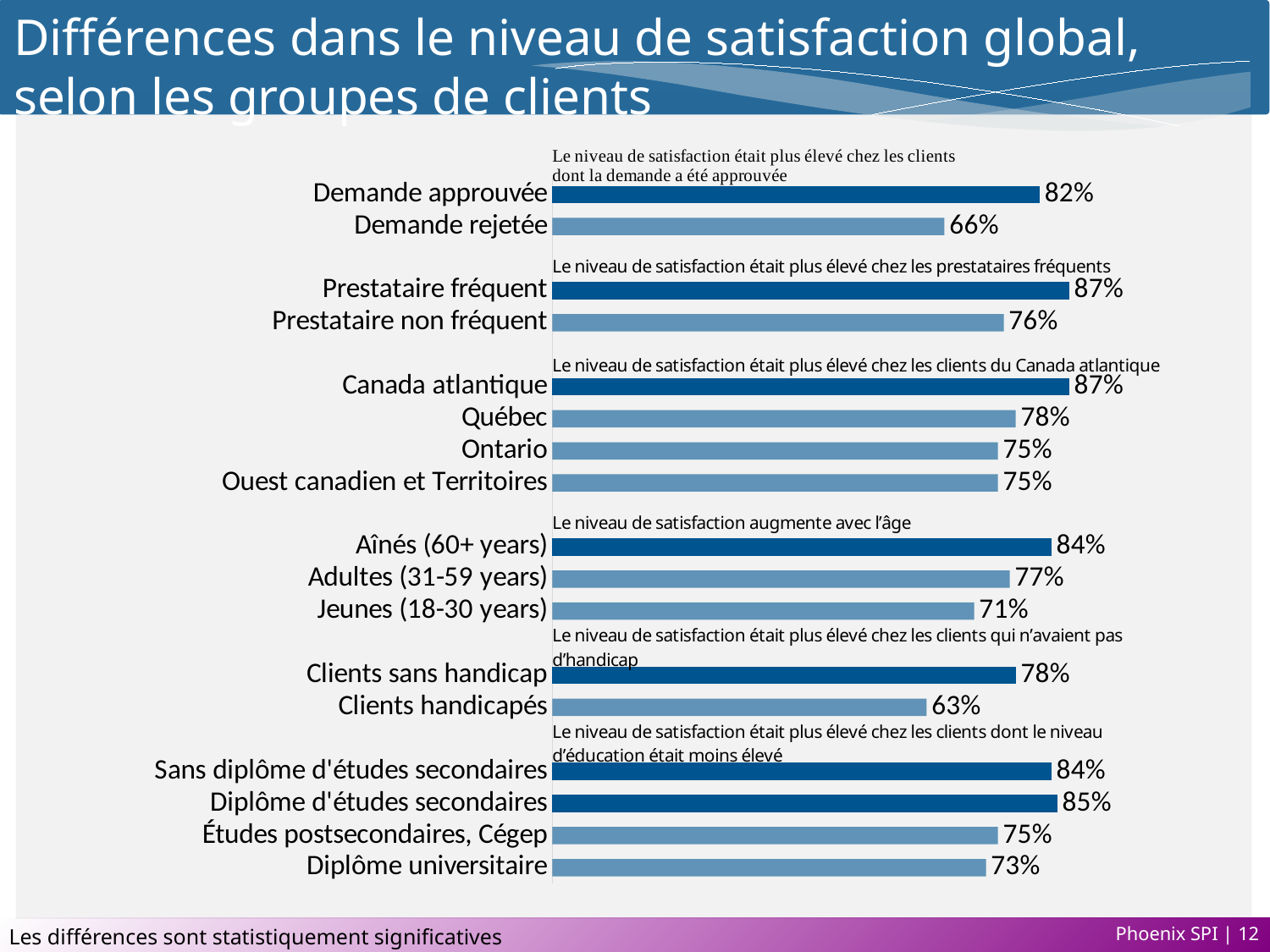
What is the value for Demande approuvée? 82% Which category has the lowest value on the chart? Clients handicapés What kind of chart is shown on the slide? Bar chart What is the value for Clients handicapés? 63% What is the value for Diplôme universitaire? 73% How many categories (bars) are plotted on the chart? 17 What is the difference between the values for Demande approuvée and Demande rejetée? 16% What is the value for Jeunes (18-30 years)? 71% Which is larger, the value for Aînés (60+ years) or the value for Adultes (31-59 years)? Aînés (60+ years) What is the difference between the values for Clients sans handicap and Clients handicapés? 15% Which is larger, the value for Québec or the value for Ontario? Québec What is the value for Prestataire non fréquent? 76%